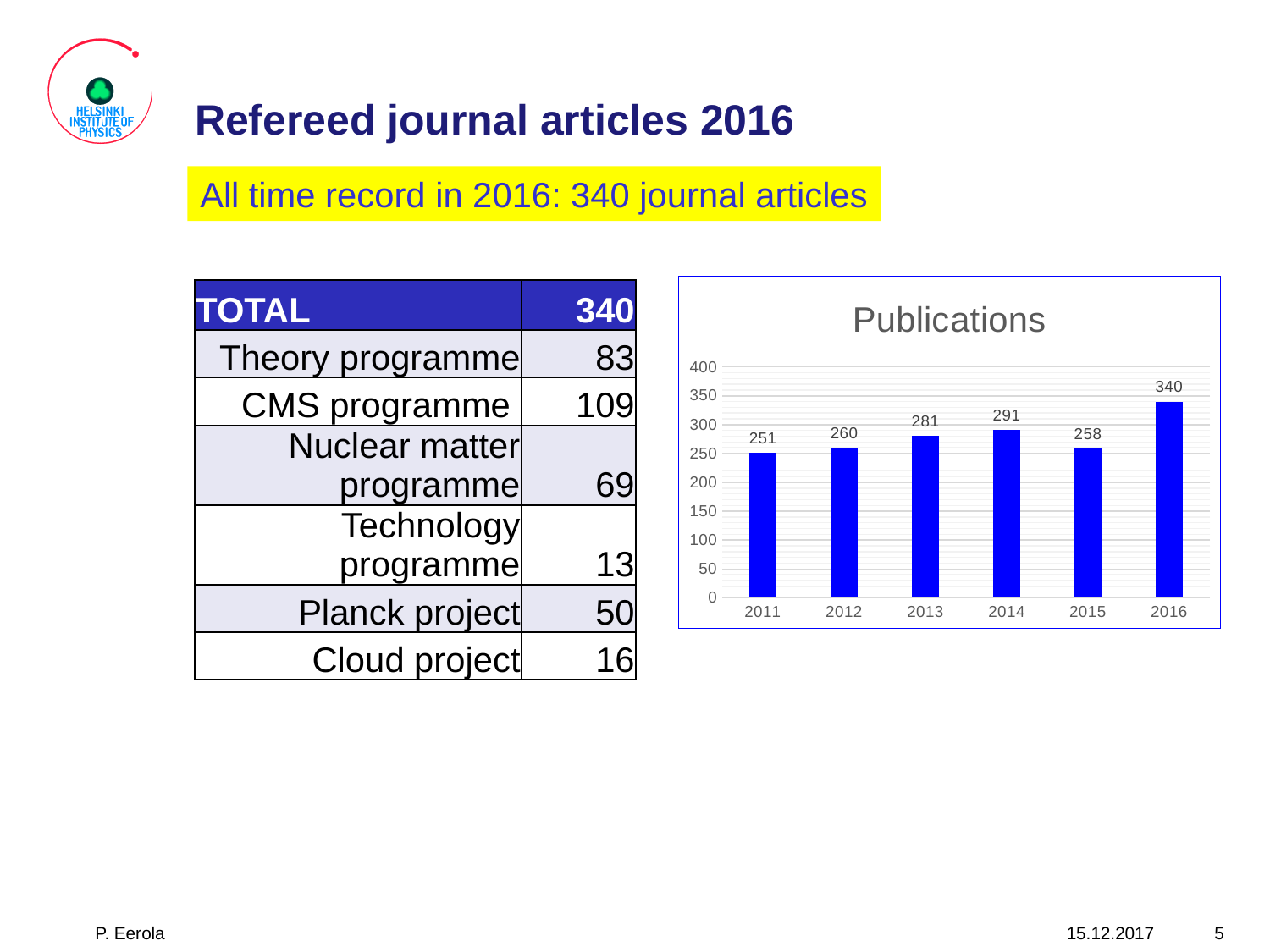
What is the value for 2014 in the Publications chart? 291 What is the title of the chart on the slide? Publications What is the value for 2015 in the Publications chart? 258 Is the value for 2016 in the Publications chart greater or less than 300? greater Which year has the lowest value in the Publications chart? 2011 Which is larger in the Publications chart, the value for 2014 or the value for 2015? 2014 What is the value for 2011 in the Publications chart? 251 What is the difference between the values for 2013 and 2012 in the Publications chart? 21 What is the difference between the values for 2016 and 2015 in the Publications chart? 82 Which year has the highest value in the Publications chart? 2016 What kind of chart is the Publications chart? bar chart How many years are shown on the x axis of the Publications chart? 6